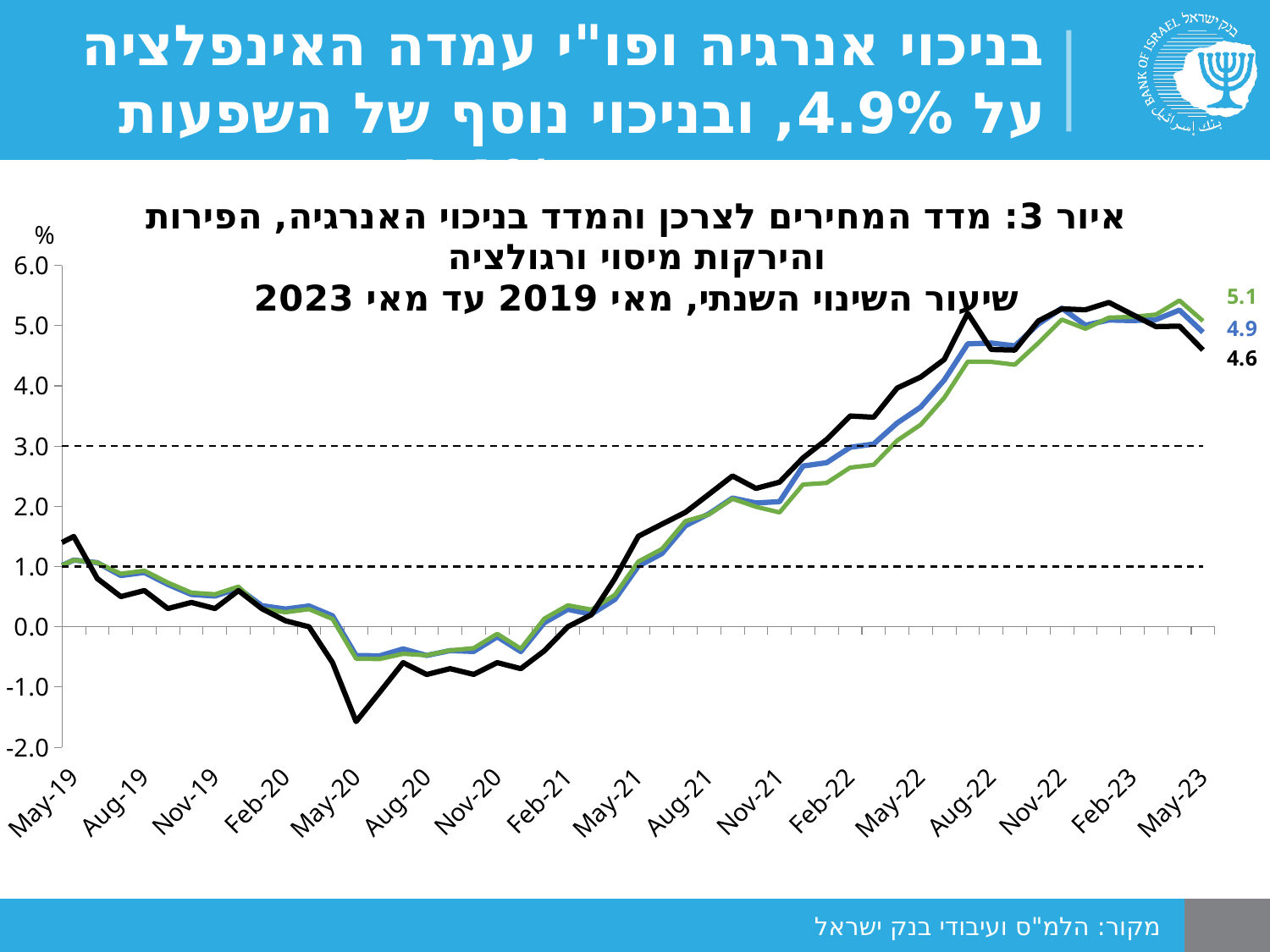
What is the final value (May-23) labelled on the black line? 4.6 Which line has the highest labelled value at May-23? the green line (5.1) Which line has the lowest labelled value at May-23? the black line (4.6) Is the value of the black line at May-20 greater or less than -1.0? less What is the final value (May-23) labelled on the green line? 5.1 What type of chart is shown on the slide? line chart What is the final value (May-23) labelled on the blue line? 4.9 How many lines are plotted on the chart? 5 (3 solid lines and 2 dashed horizontal lines) At May-23, is the blue line's labelled value larger than the black line's? yes, 4.9 vs 4.6 What unit is shown at the top of the vertical axis? % What is the difference between the green line's and the black line's labelled values at May-23? 0.5 Overall, do the lines rise or fall between May-21 and Aug-22? rise